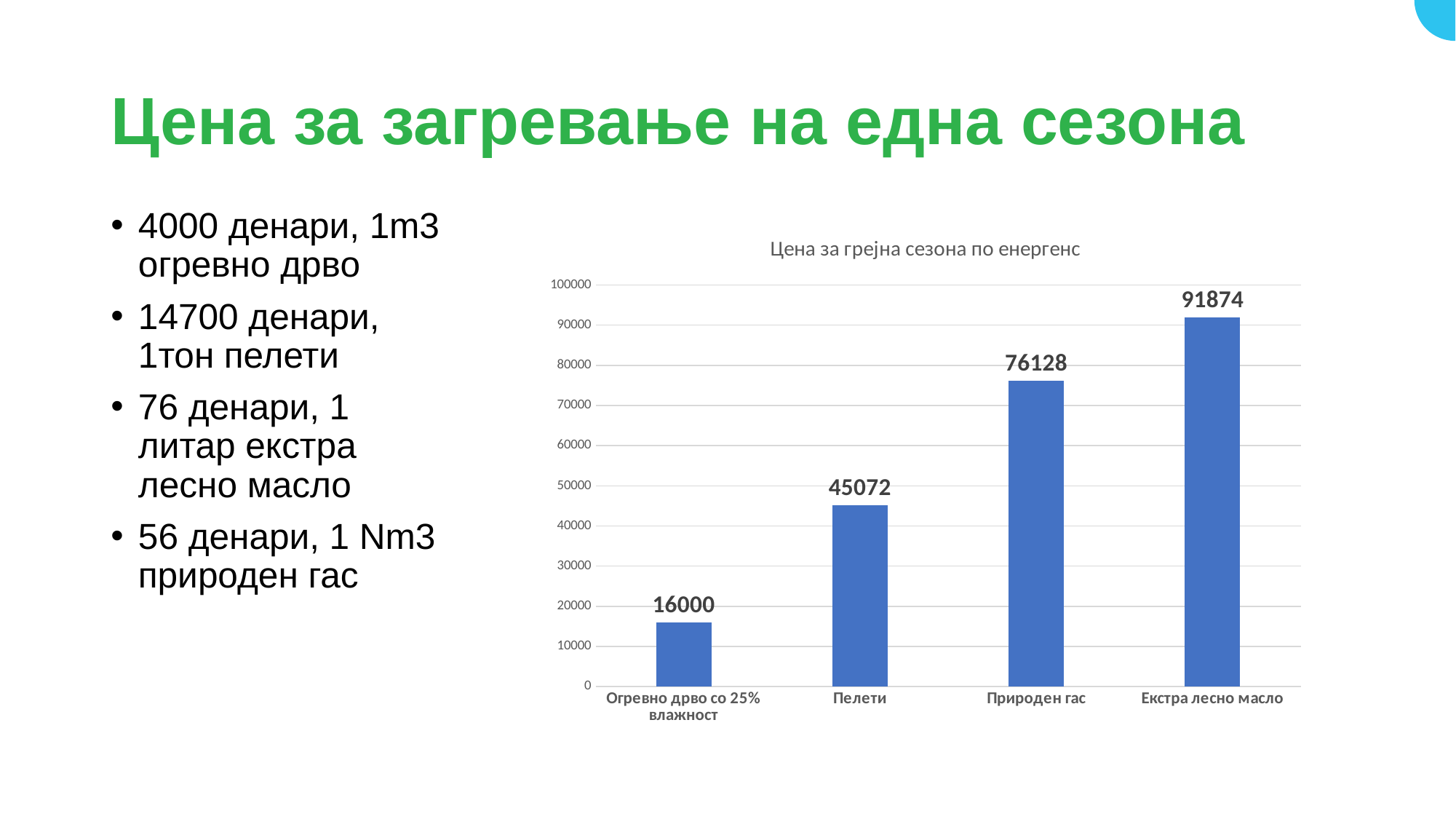
Which is larger, the value for Пелети or the value for Природен гас? Природен гас What is the title of the chart? Цена за грејна сезона по енергенс Which category has the highest value? Екстра лесно масло Is the value for Екстра лесно масло greater or less than 90000? greater What is the value for Огревно дрво со 25% влажност? 16000 Which category has the lowest value? Огревно дрво со 25% влажност What is the value for Природен гас? 76128 What is the difference between the values for Екстра лесно масло and Природен гас? 15746 What is the value for Пелети? 45072 Do the values rise or fall from left to right along the x axis? rise How many categories are shown on the x axis? 4 What kind of chart is shown? bar chart